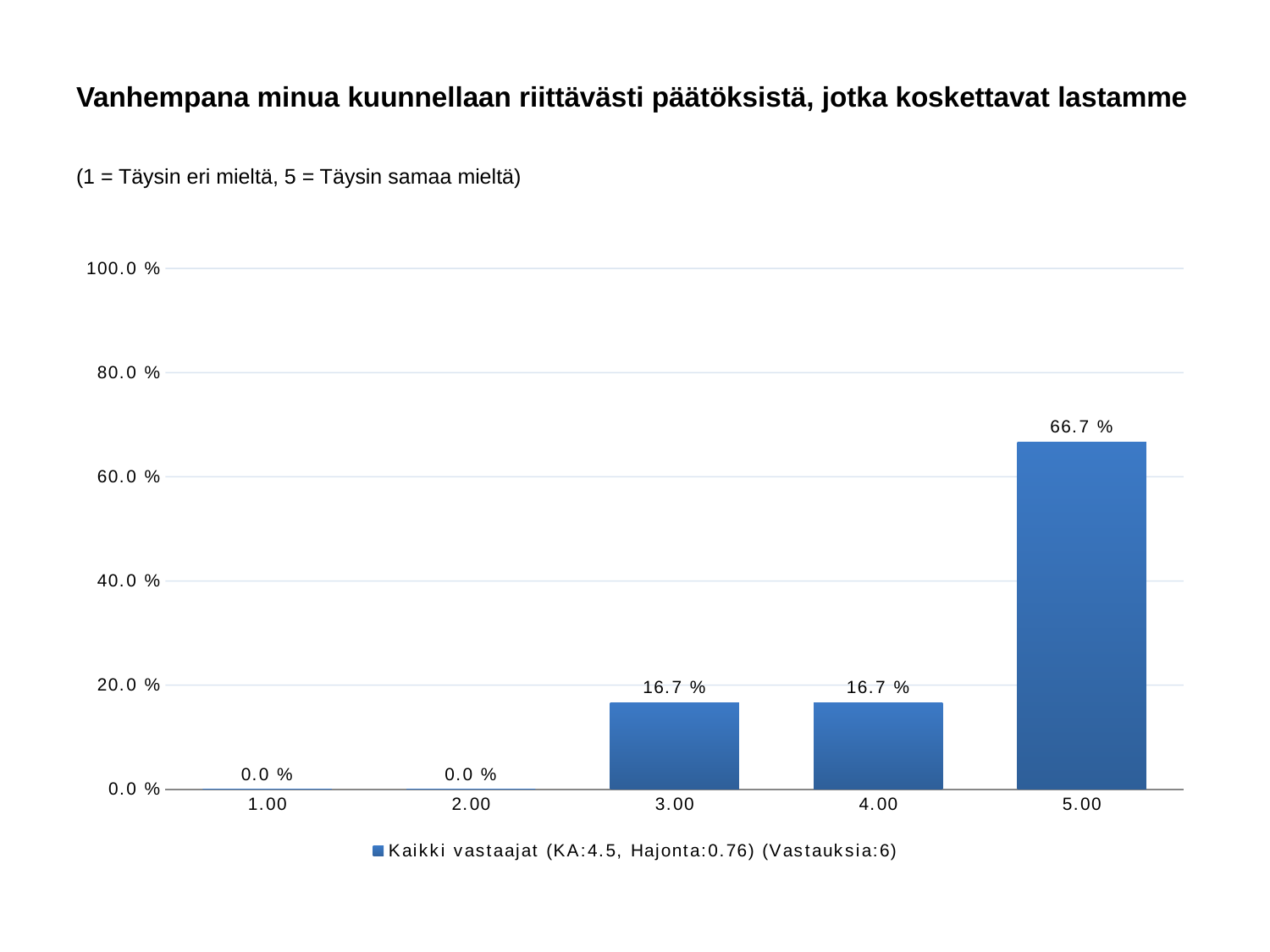
What is the legend entry for the series? Kaikki vastaajat (KA:4.5, Hajonta:0.76) (Vastauksia:6) What is the value for category 1.00? 0.0 % What is the value for category 3.00? 16.7 % Which is larger, the value for 3.00 or the value for 5.00? 5.00 Is the value for 5.00 greater or less than 60.0 %? greater What is the title of the chart? Vanhempana minua kuunnellaan riittävästi päätöksistä, jotka koskettavat lastamme Which category has the highest value? 5.00 How many series does the legend list? 1 How many categories are shown on the x axis? 5 What is the value for category 5.00? 66.7 % What is the difference between the values for 5.00 and 4.00? 50.0 % What kind of chart is shown? bar chart